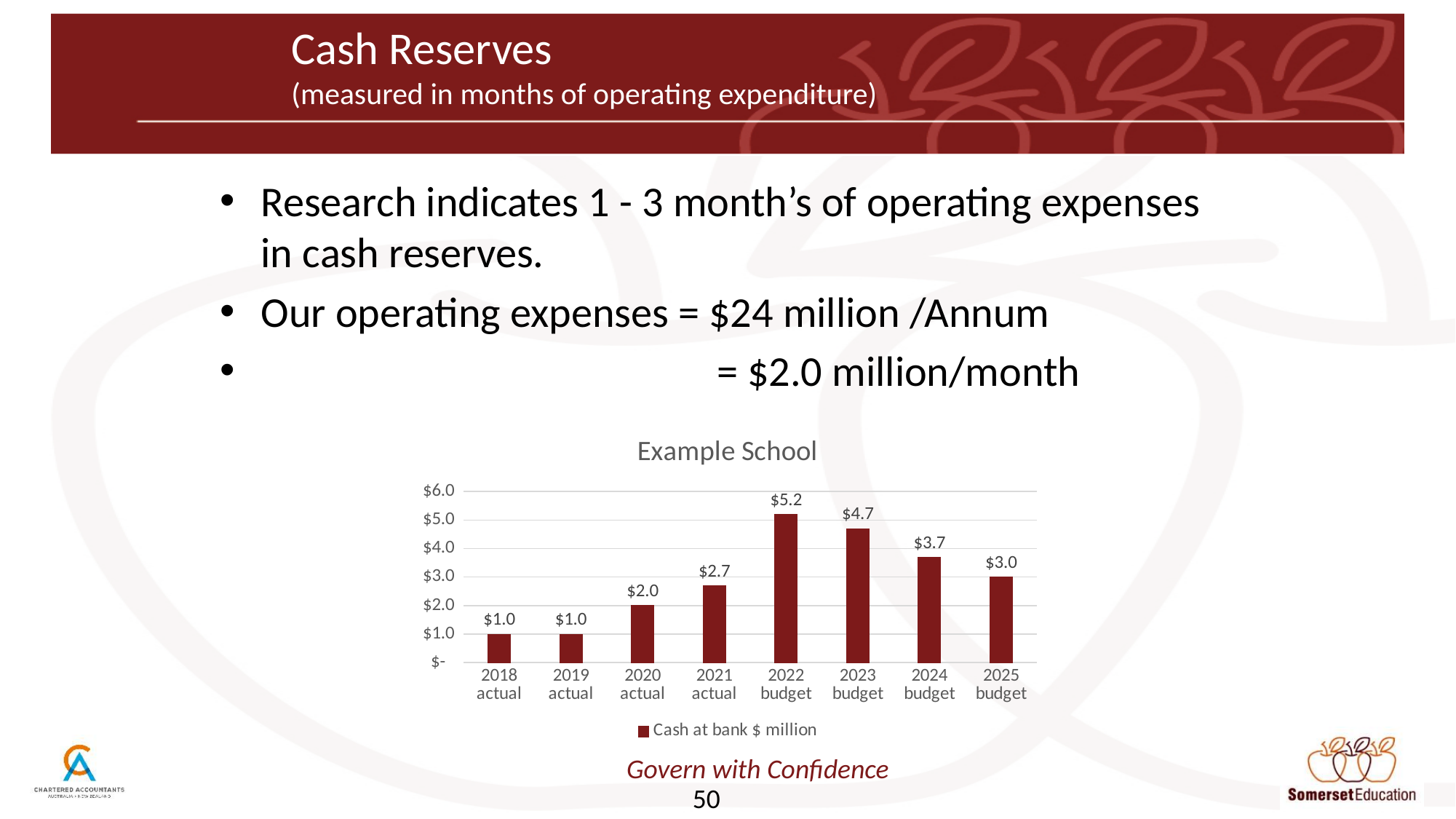
What is the value for 2022 budget? $5.2 Is the value for 2023 budget greater or less than $4.0? greater Which category has the highest value? 2022 budget How many series does the legend list? 1 What kind of chart is shown? bar chart What is the value for 2025 budget? $3.0 What is the value for 2020 actual? $2.0 How many categories are shown on the x axis? 8 What is the difference between the values for 2021 actual and 2020 actual? $0.7 What is the title of the chart? Example School Which is larger, the value for 2024 budget or the value for 2025 budget? 2024 budget What is the difference between the values for 2022 budget and 2023 budget? $0.5